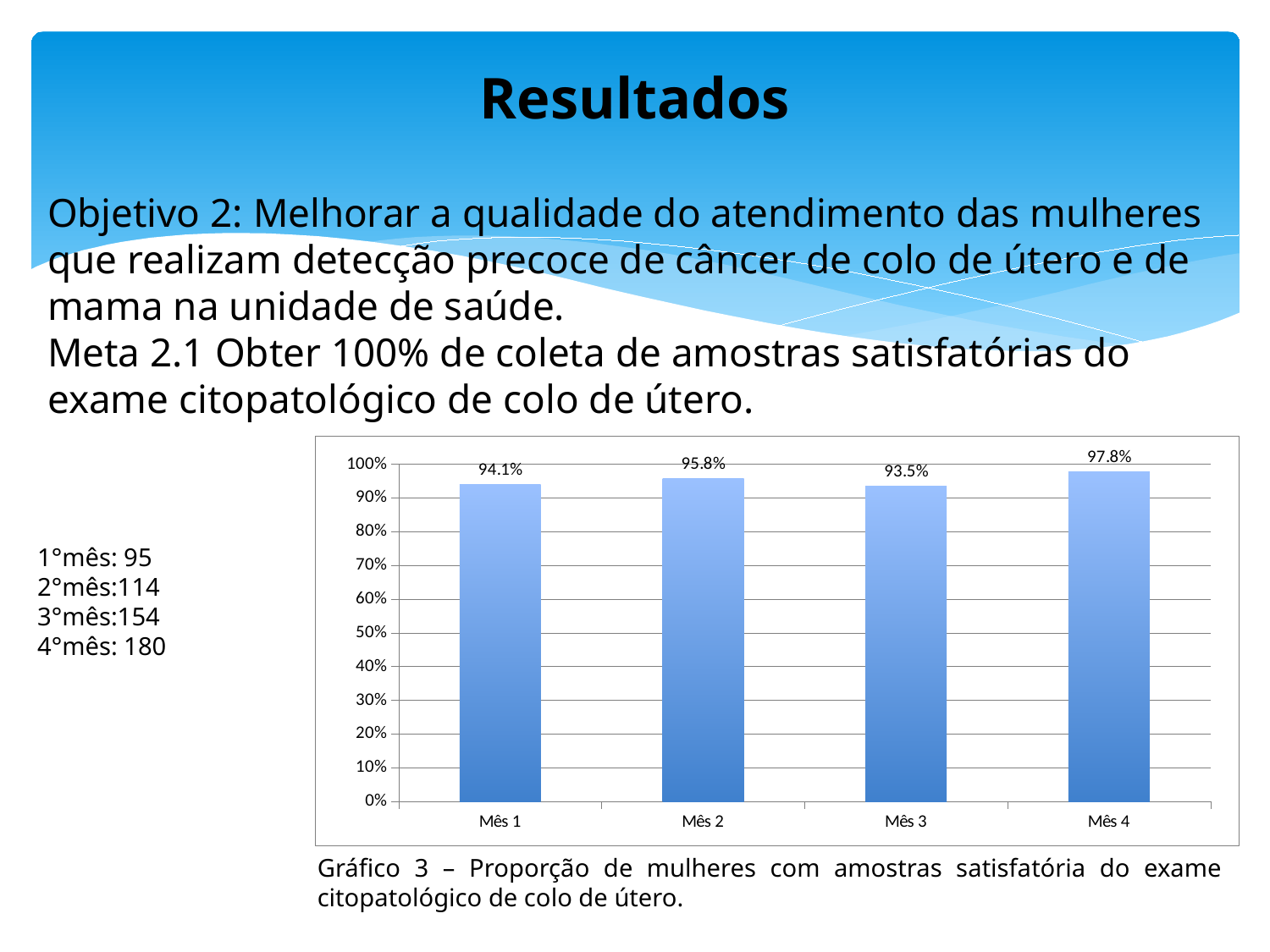
What is the value for Mês 3? 93.5% What is the difference between the values for Mês 4 and Mês 3? 4.3% What kind of chart is shown on the slide? bar chart Is the value for Mês 3 greater or less than 90%? greater Which month has the highest value? Mês 4 What is the highest value shown on the y axis? 100% Which month has the lowest value? Mês 3 How many months are shown on the x axis? 4 Which is larger, the value for Mês 2 or the value for Mês 1? Mês 2 What is the value for Mês 4? 97.8% What is the value for Mês 2? 95.8% What is the value for Mês 1? 94.1%